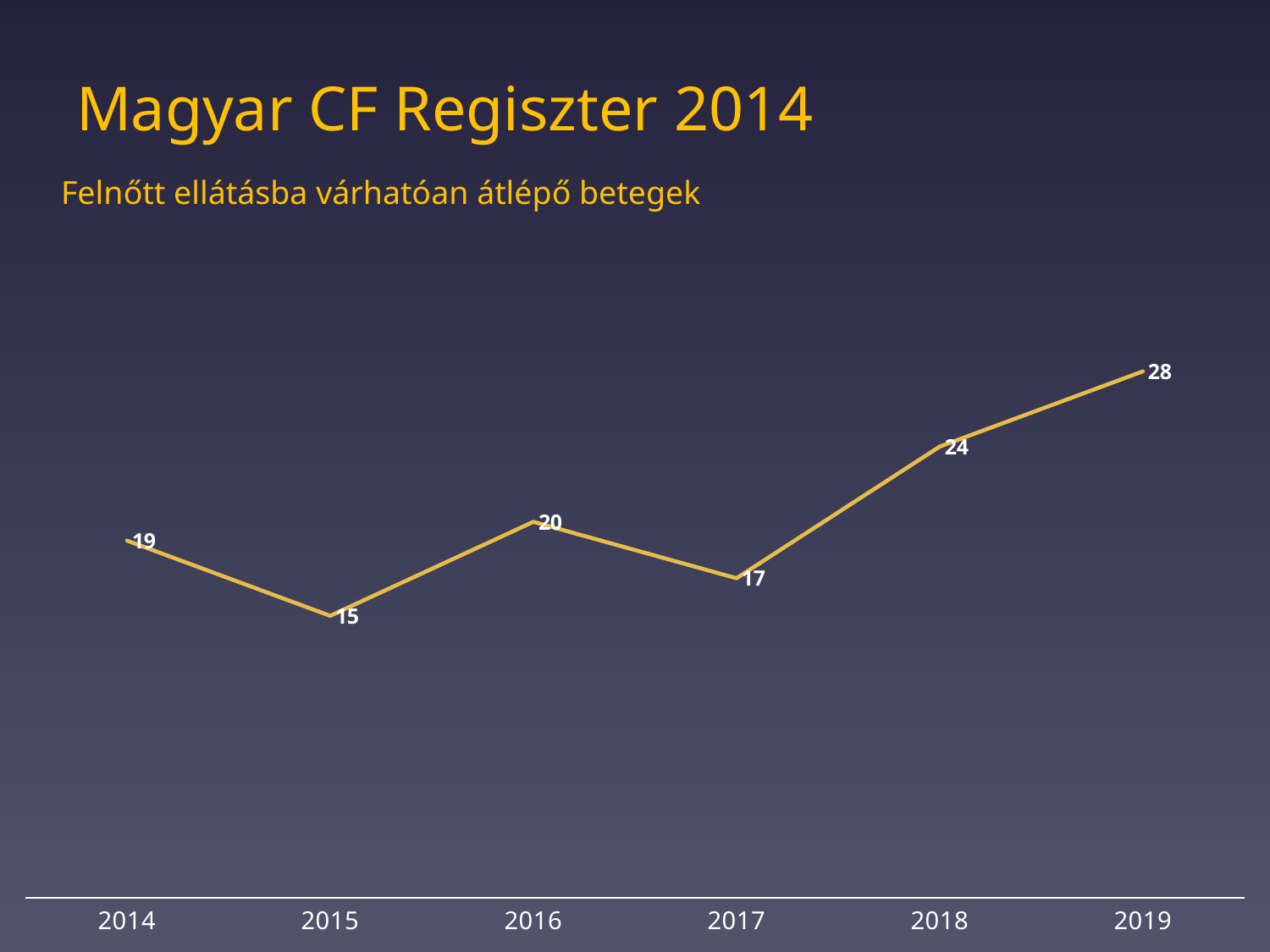
What is the value for 2017? 17 Do the values rise or fall from 2017 to 2019? rise What is the value for 2019? 28 Which year has the lowest value? 2015 How many years are plotted on the chart? 6 Which is larger, the value for 2016 or the value for 2017? 2016 What is the difference between the values for 2019 and 2018? 4 What is the value for 2015? 15 What kind of chart is shown on the slide? line chart Which year has the highest value? 2019 What is the difference between the values for 2016 and 2015? 5 What is the value for 2014? 19